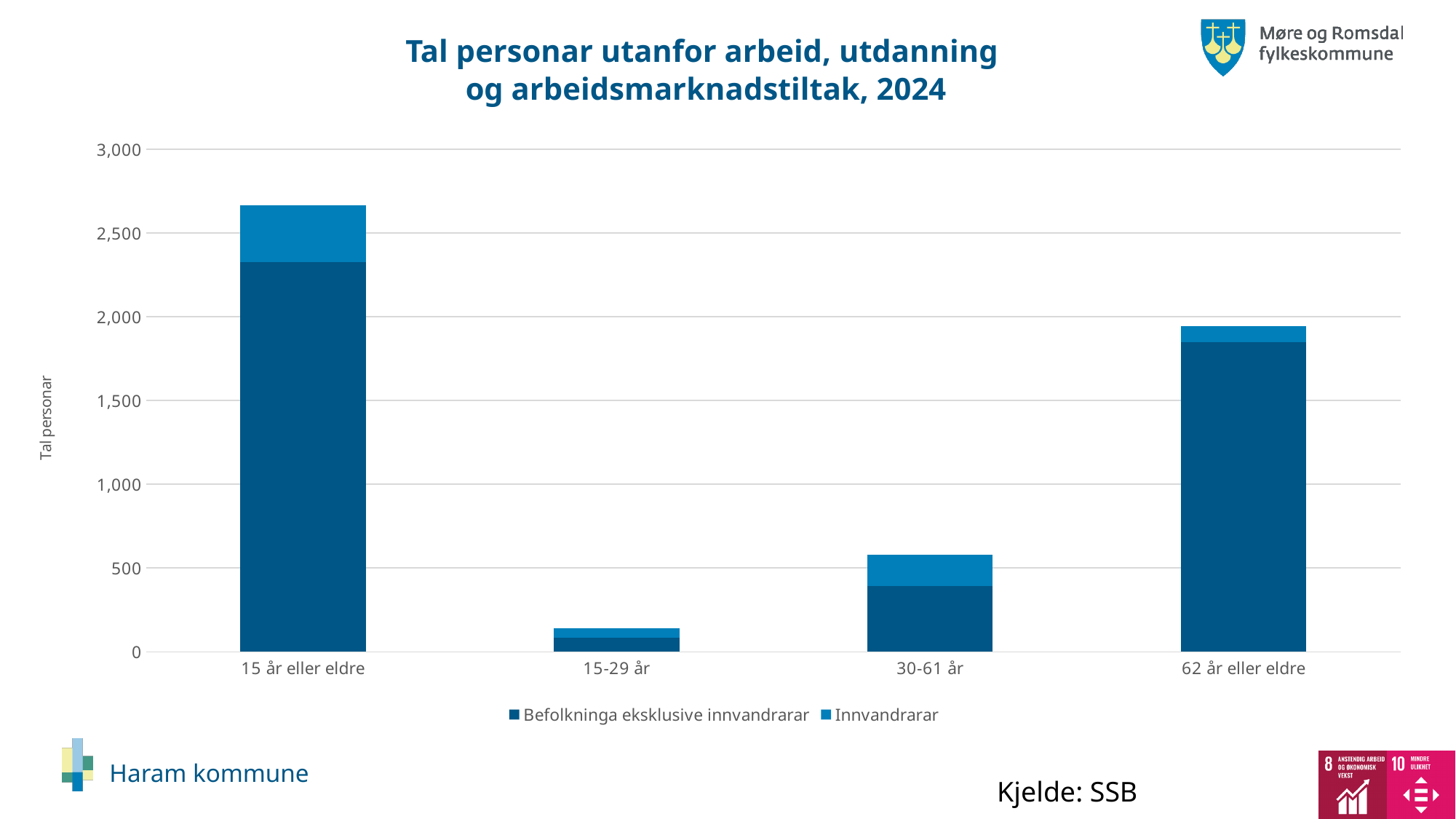
What kind of chart is shown on the slide? Stacked bar chart Is the total bar for 15 år eller eldre greater or less than 2,500? greater Which category has the highest total bar? 15 år eller eldre Which category has the lowest total bar? 15-29 år How many age categories are shown on the x axis? 4 Which series is shown in the lighter blue colour? Innvandrarar What is the label on the y axis? Tal personar Is the Befolkninga eksklusive innvandrarar value for 15 år eller eldre greater or less than 2,000? greater How many series does the legend list? 2 Which total bar is larger, 30-61 år or 15-29 år? 30-61 år Is the total bar for 30-61 år greater or less than 500? greater